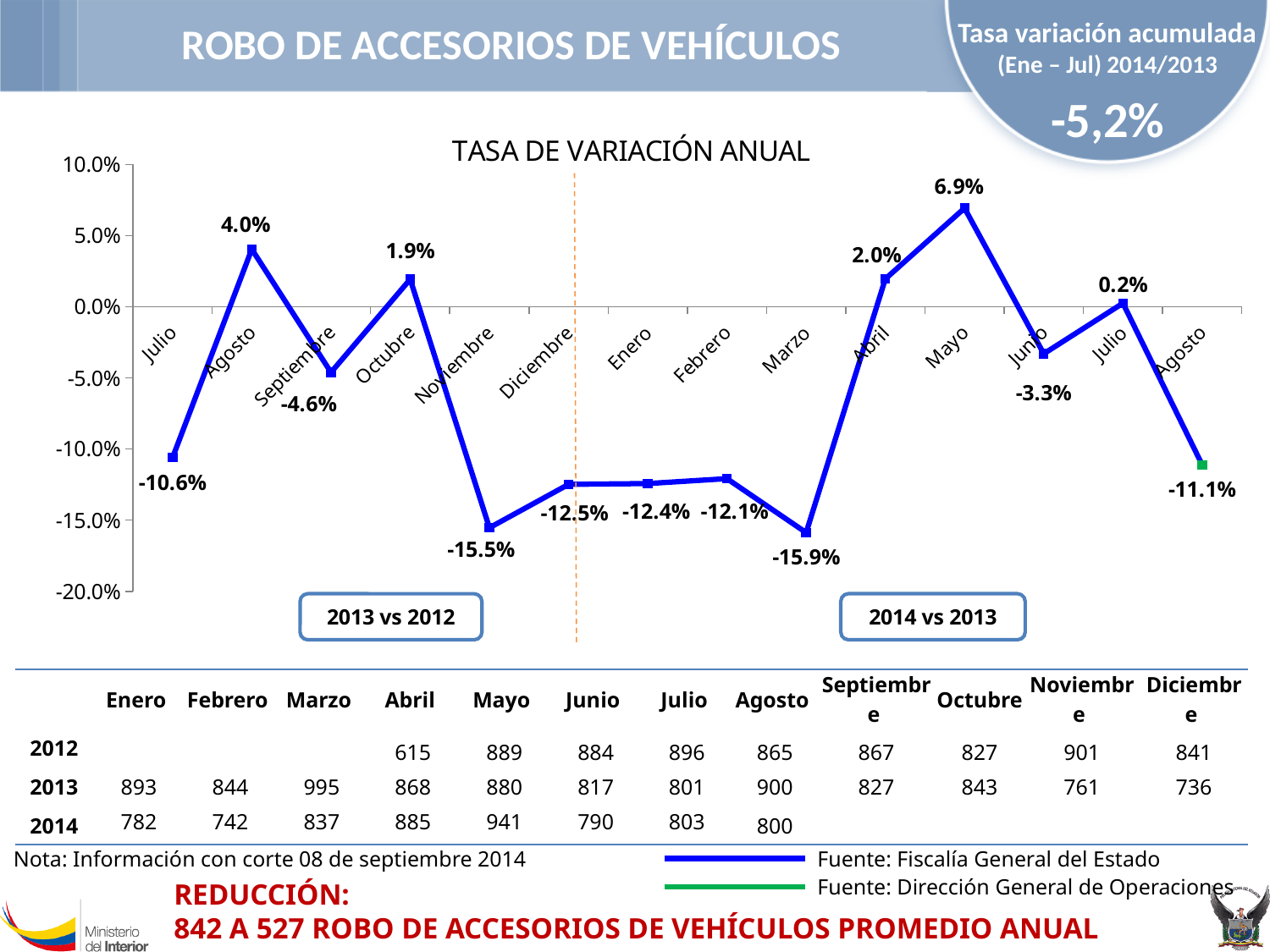
In the TASA DE VARIACIÓN ANUAL chart, what is the value for Mayo in the 2014 vs 2013 section? 6.9% In the TASA DE VARIACIÓN ANUAL chart, what is the value for Agosto in the 2014 vs 2013 section? -11.1% In the TASA DE VARIACIÓN ANUAL chart, is the value for Marzo greater or less than -15.0%? less What type of chart is shown under the title TASA DE VARIACIÓN ANUAL? line chart What is the accumulated variation rate (Ene – Jul) 2014/2013 shown in the circle at the top right of the slide? -5,2% In the TASA DE VARIACIÓN ANUAL chart, what is the difference between the value for Mayo (6.9%) and the value for Abril (2.0%)? 4.9% In the TASA DE VARIACIÓN ANUAL chart, which month has the lowest value? Marzo In the TASA DE VARIACIÓN ANUAL chart, does the line rise or fall from Febrero to Marzo? fall In the TASA DE VARIACIÓN ANUAL chart, what is the value for Noviembre in the 2013 vs 2012 section? -15.5% In the TASA DE VARIACIÓN ANUAL chart, which is larger: the value for Agosto in the 2013 vs 2012 section or the value for Octubre? Agosto How many data points are plotted in the TASA DE VARIACIÓN ANUAL chart? 14 In the TASA DE VARIACIÓN ANUAL chart, which month has the highest value? Mayo